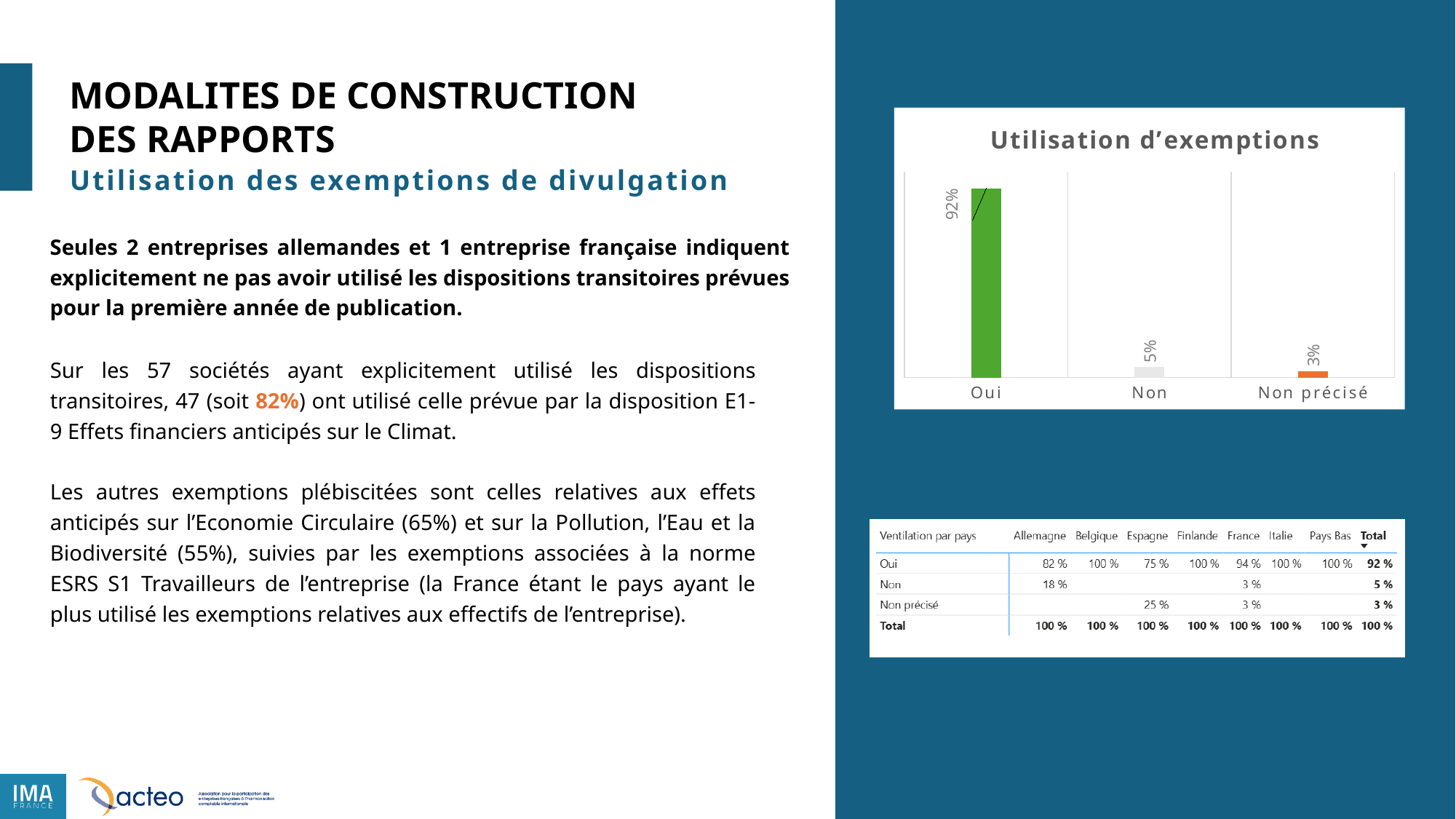
What kind of chart is the Utilisation d'exemptions chart? Bar chart Which category has the lowest value in the Utilisation d'exemptions chart? Non précisé What is the value for Oui in the Utilisation d'exemptions chart? 92% What is the title of the chart on the slide? Utilisation d'exemptions What is the value for Non précisé in the Utilisation d'exemptions chart? 3% Which is larger in the Utilisation d'exemptions chart, the value for Non or the value for Non précisé? Non Which category has the highest value in the Utilisation d'exemptions chart? Oui What is the difference between the values for Non and Non précisé in the Utilisation d'exemptions chart? 2% How many categories are shown in the Utilisation d'exemptions chart? 3 What is the value for Non in the Utilisation d'exemptions chart? 5% What colour is the bar for Oui in the Utilisation d'exemptions chart? Green What is the difference between the values for Oui and Non in the Utilisation d'exemptions chart? 87%